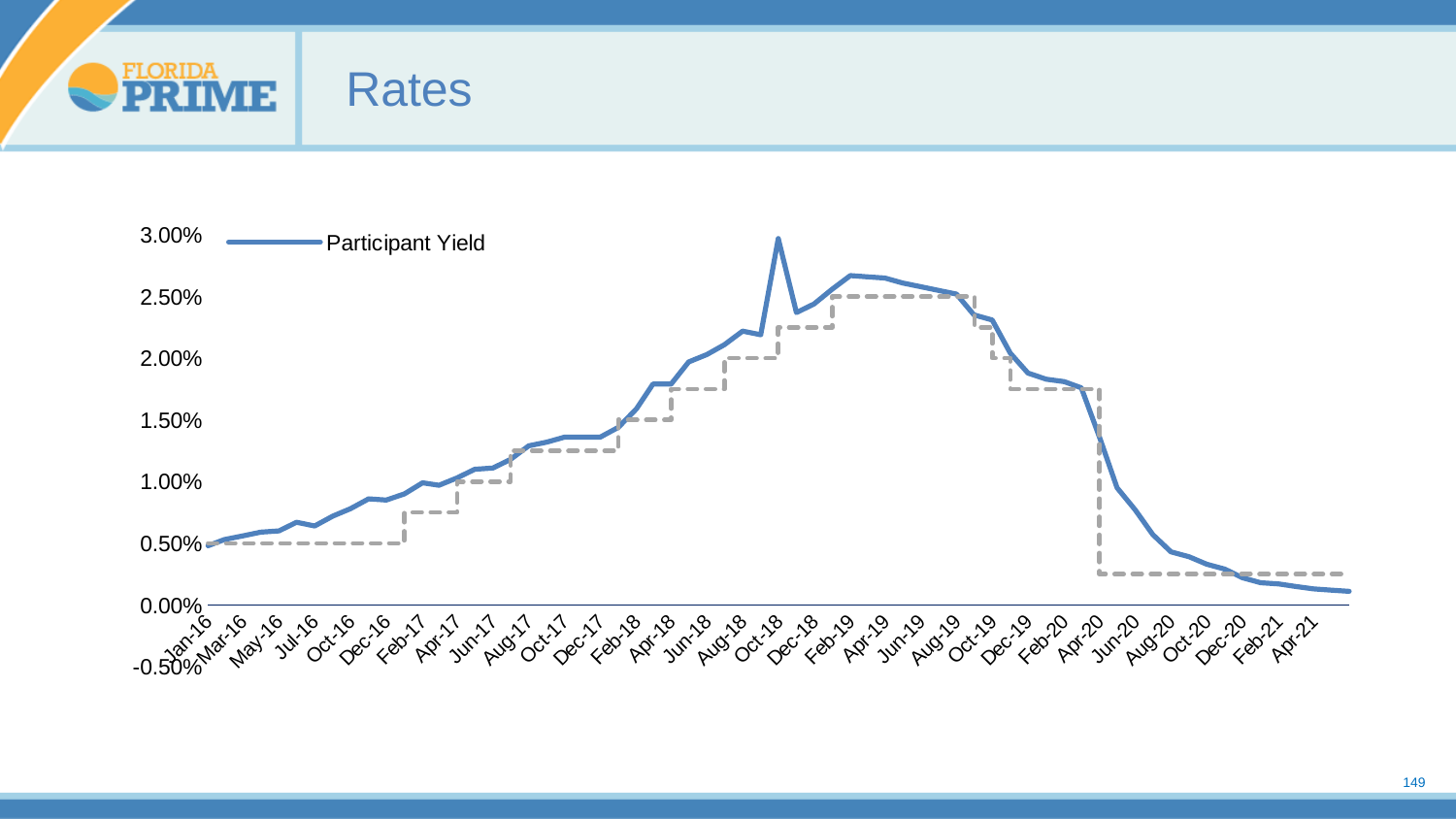
What is the title of the slide containing the chart? Rates Is the Participant Yield for Oct-18 greater or less than 2.50%? less What series name is shown in the chart legend? Participant Yield Does the Participant Yield generally rise or fall from Jan-16 to Feb-19? rise Is the Participant Yield for Aug-18 greater or less than 2.00%? greater Which is larger, the Participant Yield in Feb-19 or in Jan-16? Feb-19 What kind of chart is shown on the slide? line chart Is the Participant Yield for Dec-16 greater or less than 1.00%? less